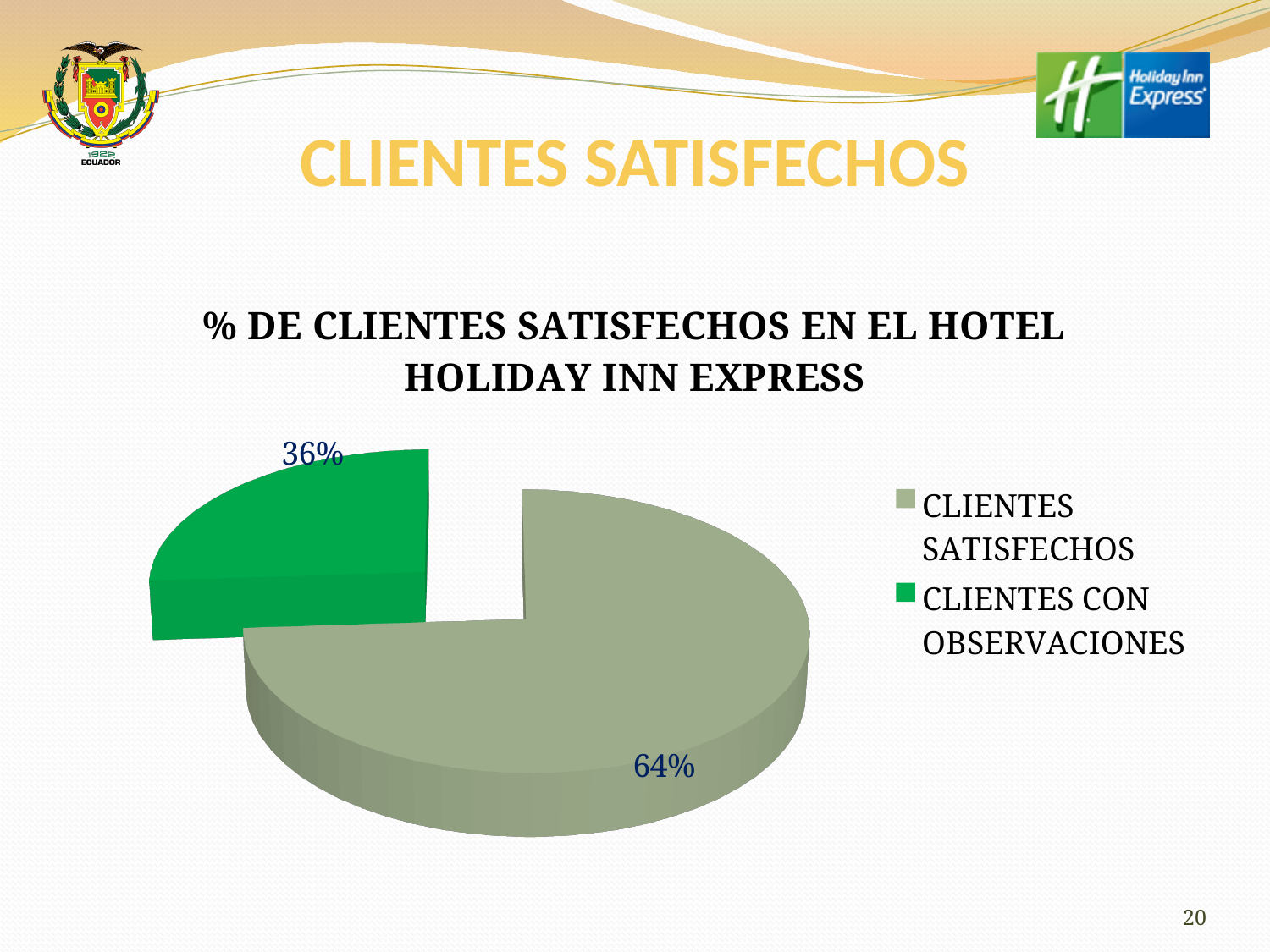
What kind of chart is shown on the slide? Pie chart What is the difference in percentage points between CLIENTES SATISFECHOS and CLIENTES CON OBSERVACIONES? 28% Which is larger, the slice for CLIENTES SATISFECHOS or the slice for CLIENTES CON OBSERVACIONES? CLIENTES SATISFECHOS Which category is shown in green in the pie chart? CLIENTES CON OBSERVACIONES How many slices does the pie chart have? 2 What is the title of the chart? % DE CLIENTES SATISFECHOS EN EL HOTEL HOLIDAY INN EXPRESS How many entries does the legend list? 2 What share of the pie does CLIENTES SATISFECHOS represent? 64% Which category has the smallest slice of the pie? CLIENTES CON OBSERVACIONES Which category has the largest slice of the pie? CLIENTES SATISFECHOS What share of the pie does CLIENTES CON OBSERVACIONES represent? 36%